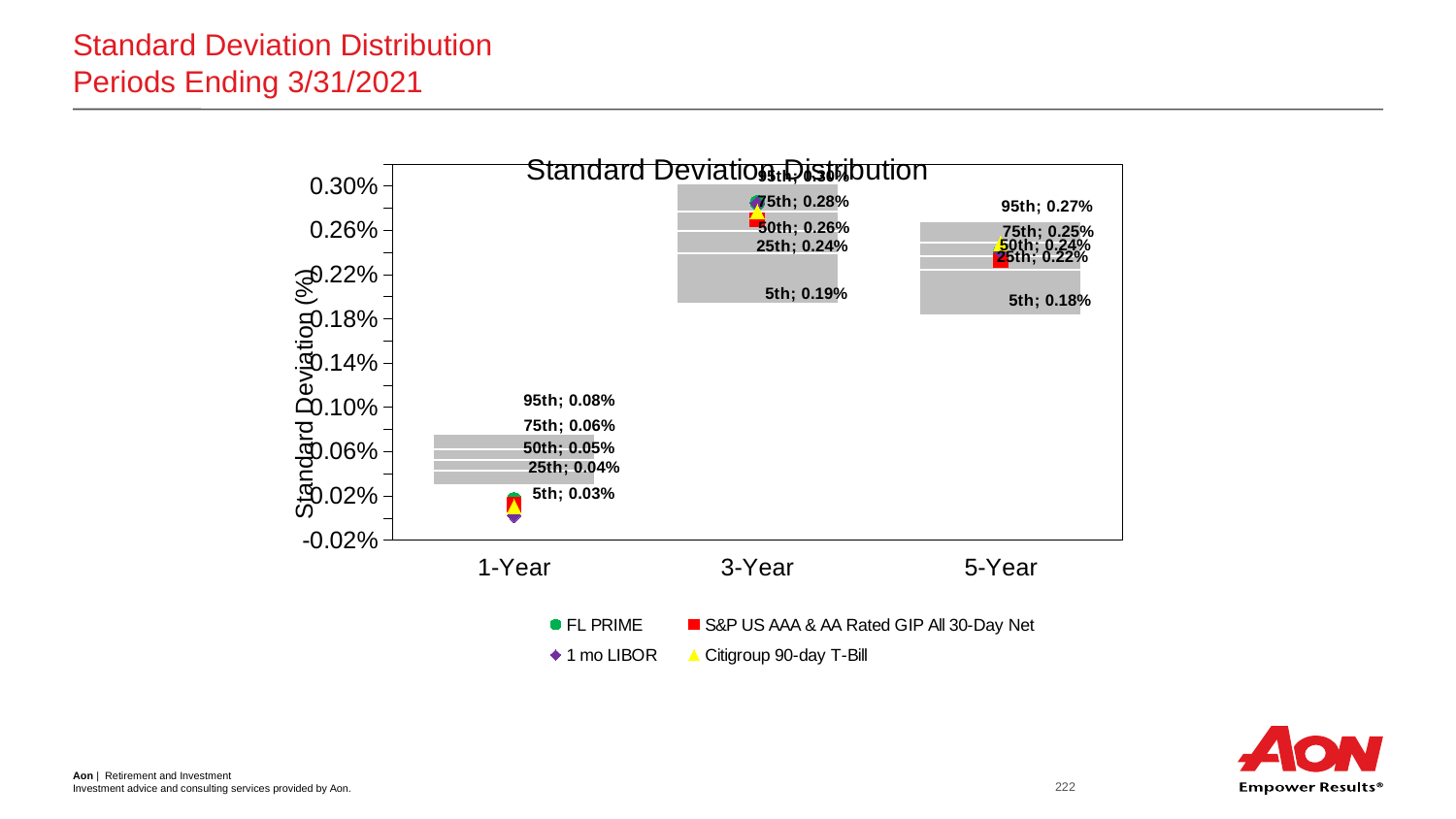
Which period has the highest 5th percentile value? 3-Year What is the 5th percentile value for the 3-Year period? 0.19% Is the 50th percentile value larger for the 3-Year period or the 5-Year period? 3-Year How many series does the legend list? 4 How many periods are shown on the x axis? 3 What is the 25th percentile value for the 1-Year period? 0.04% What is the 50th percentile value for the 5-Year period? 0.24% Which period has the lowest 50th percentile value? 1-Year What is the difference between the 95th percentile values for the 3-Year and 5-Year periods? 0.03% What is the 75th percentile value for the 5-Year period? 0.25% What is the 95th percentile value for the 1-Year period? 0.08% What is the title of the y axis? Standard Deviation (%)